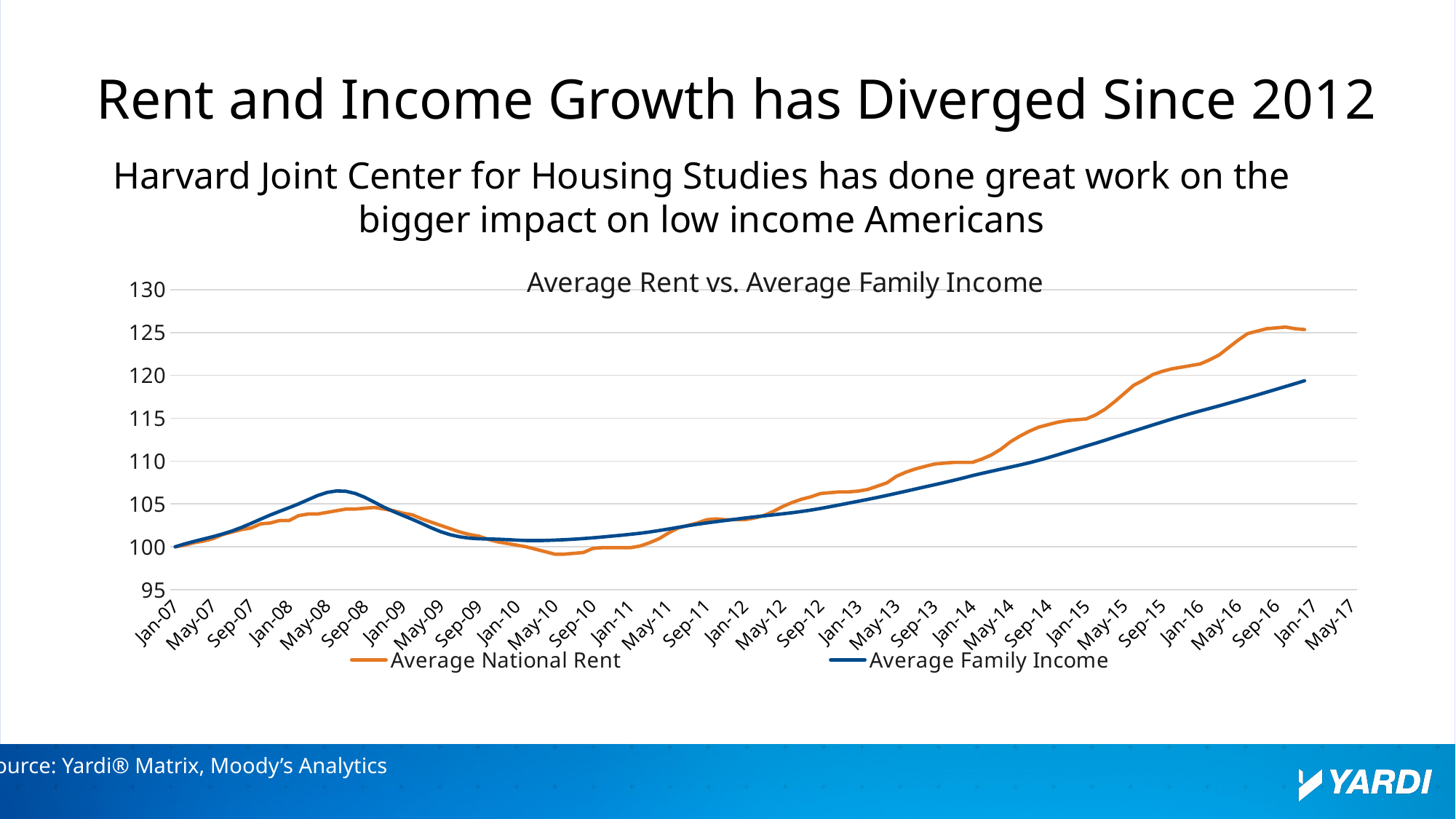
Is the value for Average National Rent at Jan-14 greater or less than 105? greater How many series does the chart's legend list? 2 Is the value for Average Family Income at Jan-10 greater or less than 105? less At May-08, which series has the higher value, Average National Rent or Average Family Income? Average Family Income What kind of chart is shown on the slide? Line chart Which series is drawn in orange? Average National Rent What is the title of the chart? Average Rent vs. Average Family Income Does Average Family Income rise or fall from Jan-12 to Jan-17? Rise Is the value for Average National Rent at May-10 greater or less than 100? less